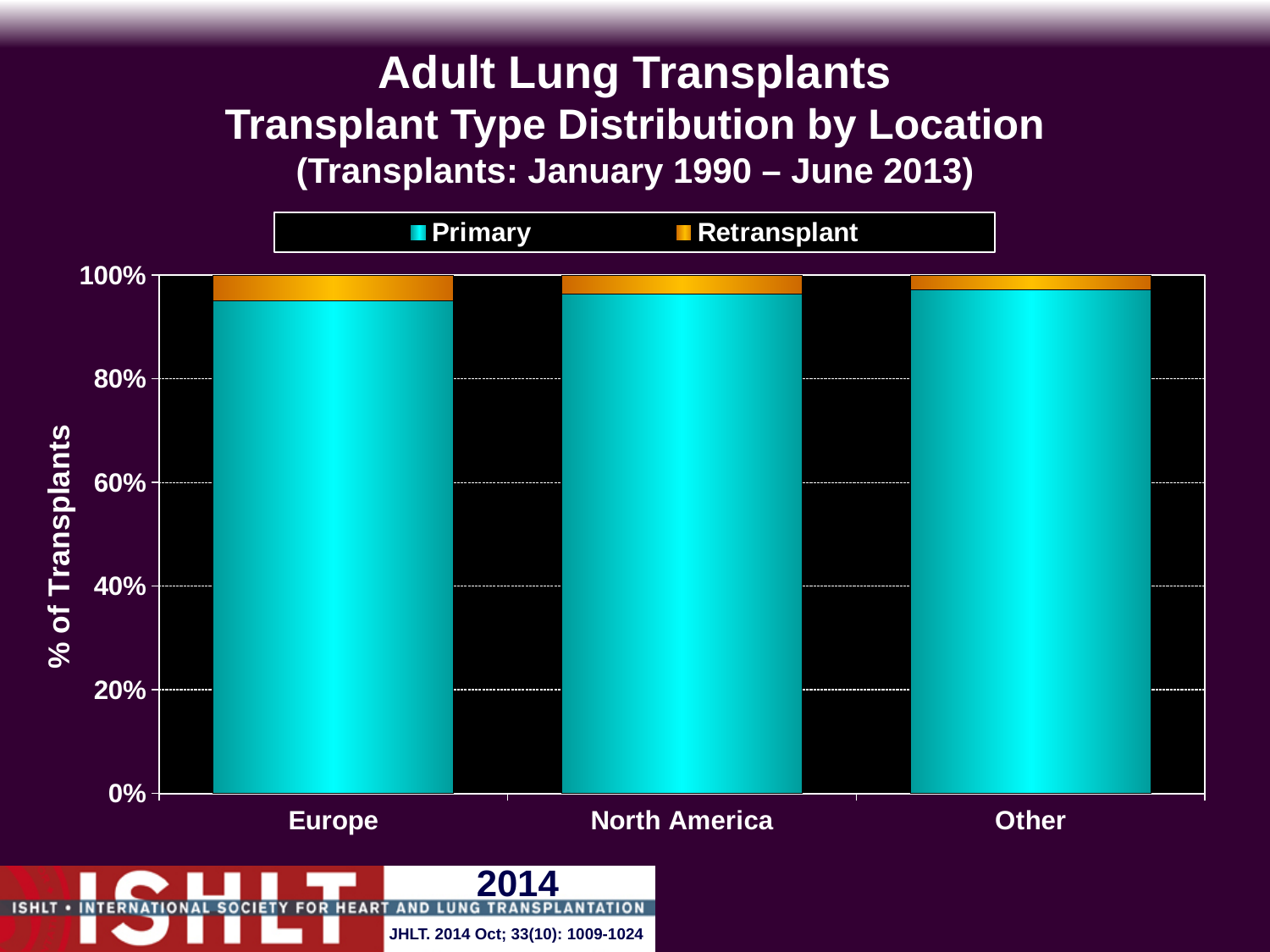
What are the two series named in the legend? Primary and Retransplant What is the label of the y axis? % of Transplants Is the Retransplant value for North America greater or less than 20%? less Is the Primary value for Other greater or less than 60%? greater What is the total height of the stacked bar for North America? 100% How many location categories are shown on the x axis? 3 How many series does the legend list? 2 What kind of chart is shown on the slide? stacked bar chart Which series makes up the larger share of the Europe bar, Primary or Retransplant? Primary Is the Primary value for Europe greater or less than 80%? greater Which series makes up the smaller share of the Other bar, Primary or Retransplant? Retransplant